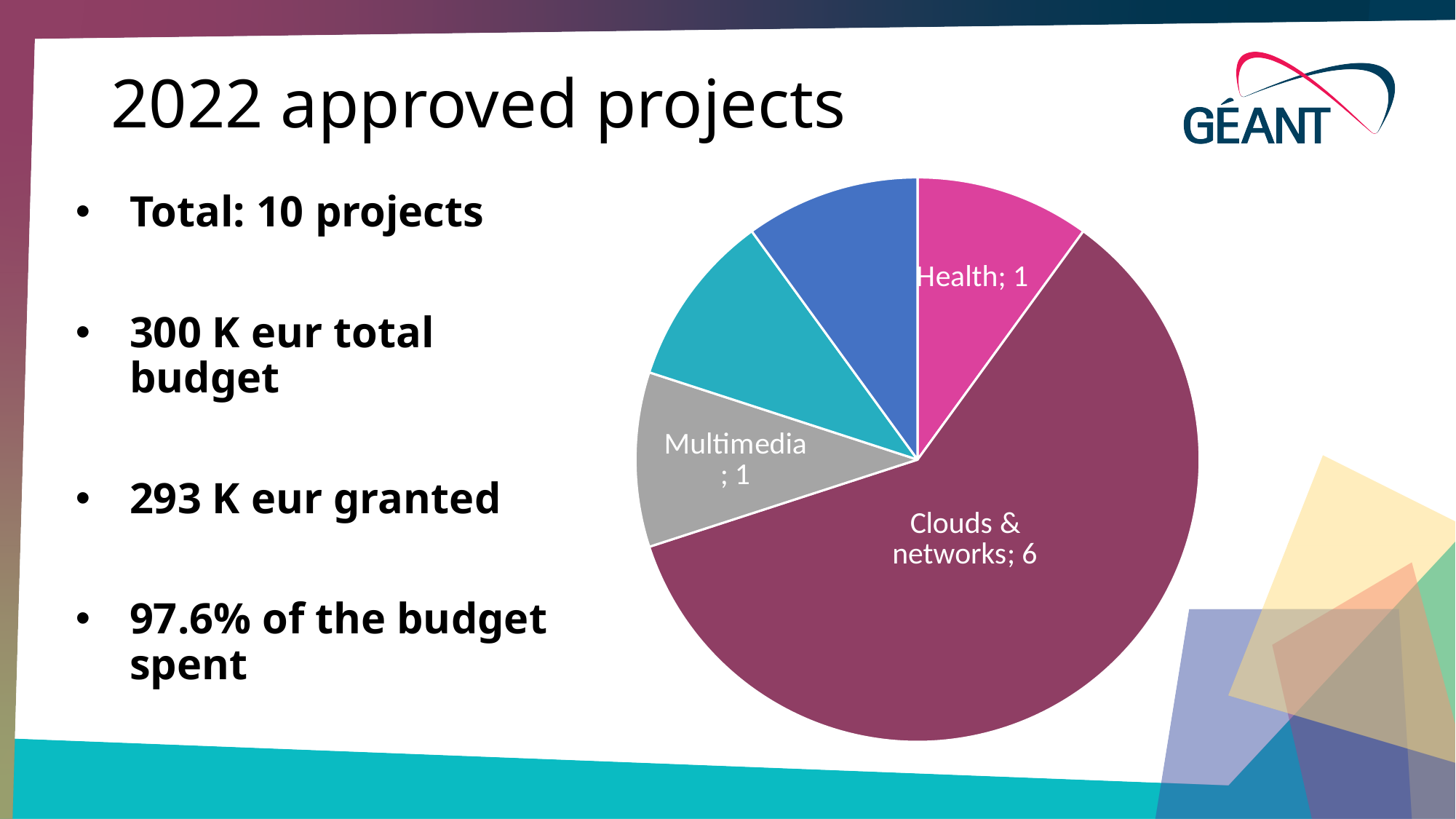
How many projects does the Clouds & networks slice represent? 6 What colour is the Health slice? pink What is the difference between the number of Clouds & networks projects and the number of Health projects? 5 What colour is the Multimedia slice? grey Which is larger, the Clouds & networks slice or the Health slice? Clouds & networks What is the difference between the number of Clouds & networks projects and the number of Multimedia projects? 5 Which labelled category has the largest slice of the pie? Clouds & networks Is the Clouds & networks slice greater or less than half of the pie? greater What kind of chart is shown on the slide? pie chart How many slices does the pie chart have? 5 How many projects does the Health slice represent? 1 How many projects does the Multimedia slice represent? 1